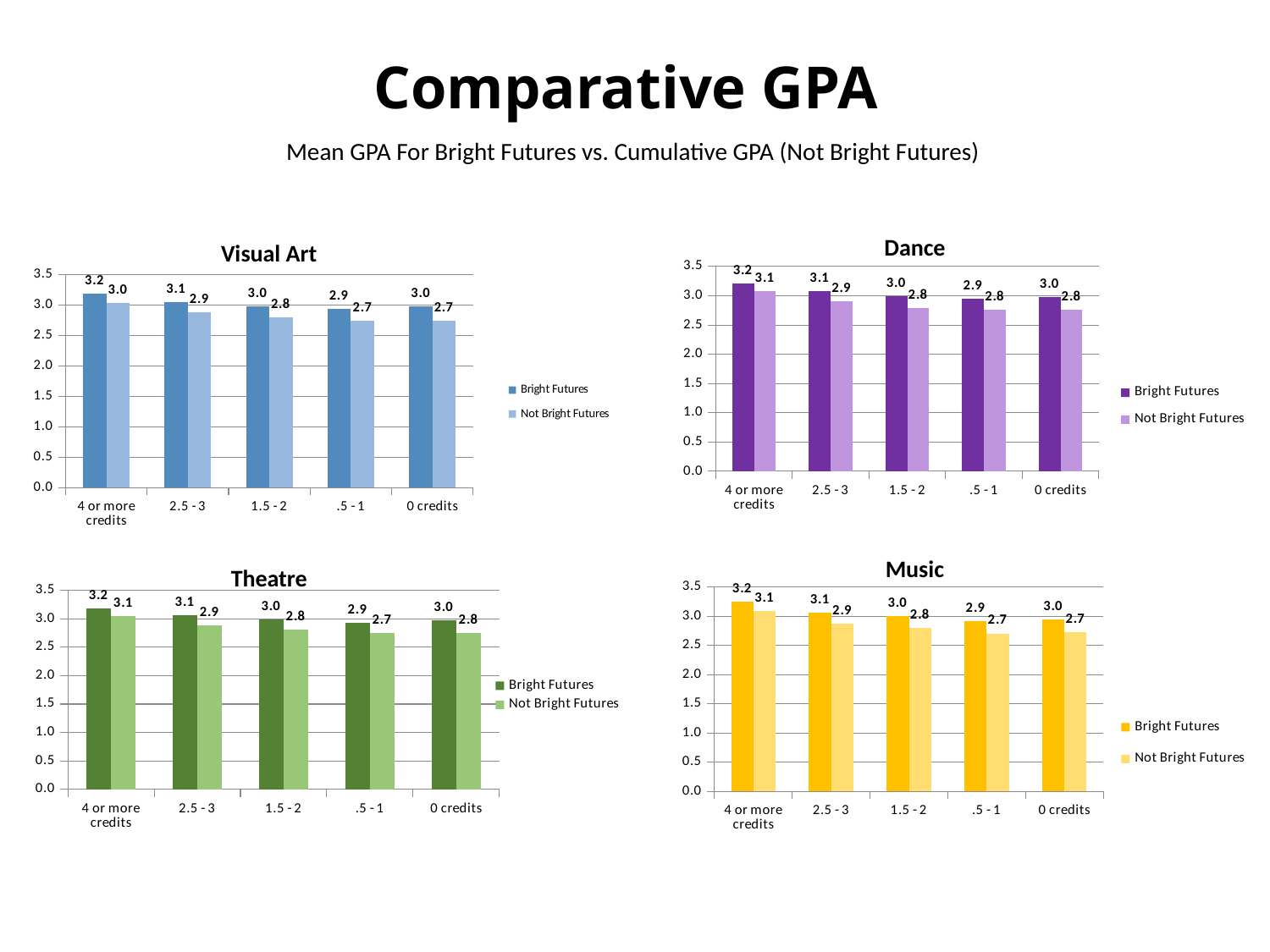
In the Visual Art chart, does the Not Bright Futures value generally rise or fall from 4 or more credits to 0 credits? Fall In the Music chart, which is larger for 4 or more credits: Bright Futures or Not Bright Futures? Bright Futures In the Dance chart, what is the Not Bright Futures value for 2.5 - 3 credits? 2.9 How many credit categories are shown on the x axis of the Theatre chart? 5 In the Visual Art chart, what is the Bright Futures value for 4 or more credits? 3.2 In the Visual Art chart, which category has the highest Bright Futures value? 4 or more credits In the Music chart, what is the Not Bright Futures value for 0 credits? 2.7 How many series does the legend of the Dance chart list? 2 What kind of chart is the Music chart? Bar chart In the Dance chart, what is the difference between the Bright Futures and Not Bright Futures values for 1.5 - 2 credits? 0.2 How many charts are shown on the slide? 4 In the Theatre chart, what is the Bright Futures value for .5 - 1 credits? 2.9